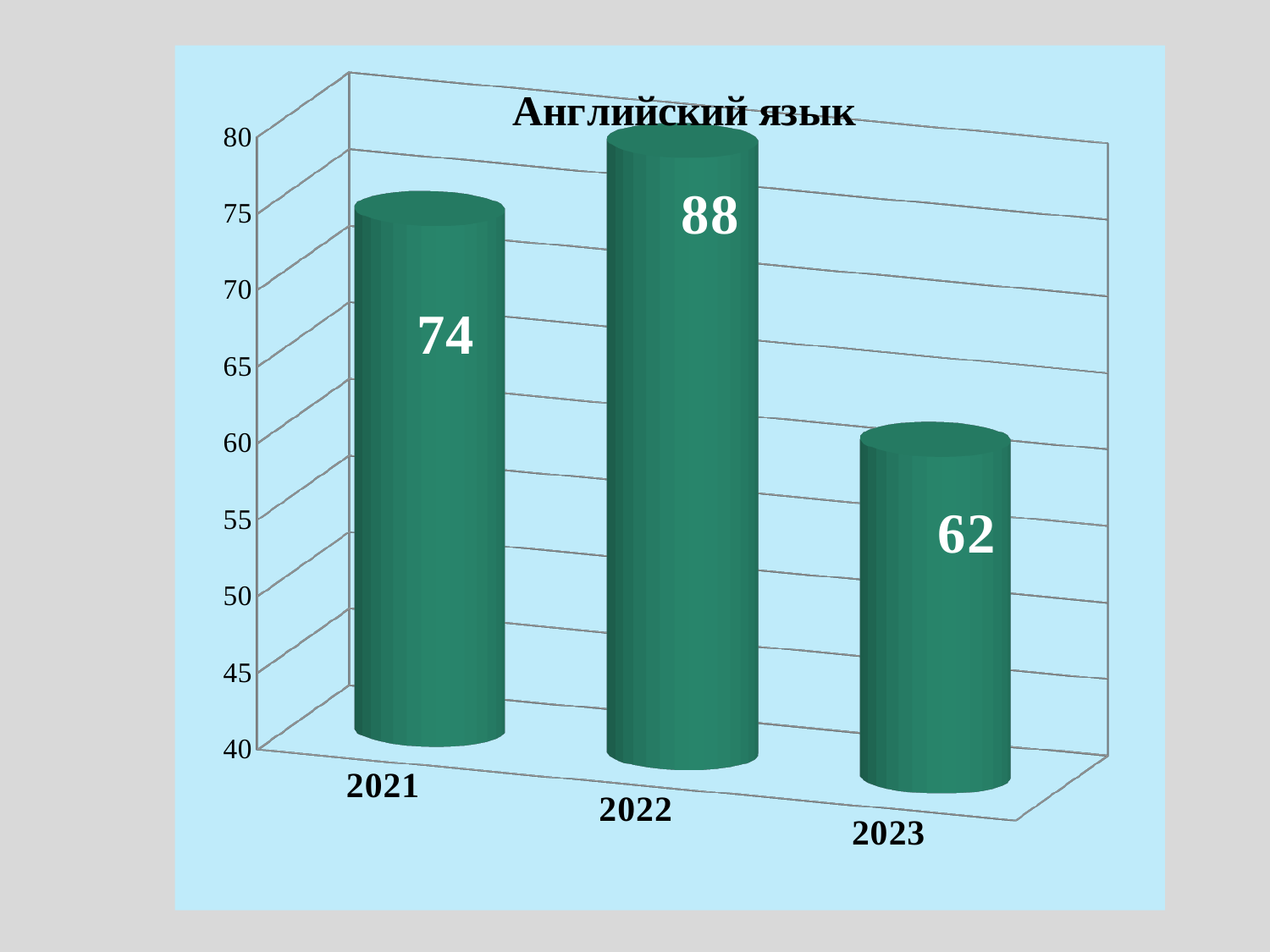
What is the difference between the values for 2021 and 2023? 12 What is the difference between the values for 2022 and 2021? 14 Which year has the highest value? 2022 What is the title of the chart? Английский язык What is the value for 2023? 62 What is the value for 2022? 88 What kind of chart is shown on the slide? bar chart Which year has the lowest value? 2023 Which is larger, the value for 2021 or the value for 2023? 2021 How many years are shown on the chart? 3 Is the value for 2023 greater or less than 65? less What is the value for 2021? 74